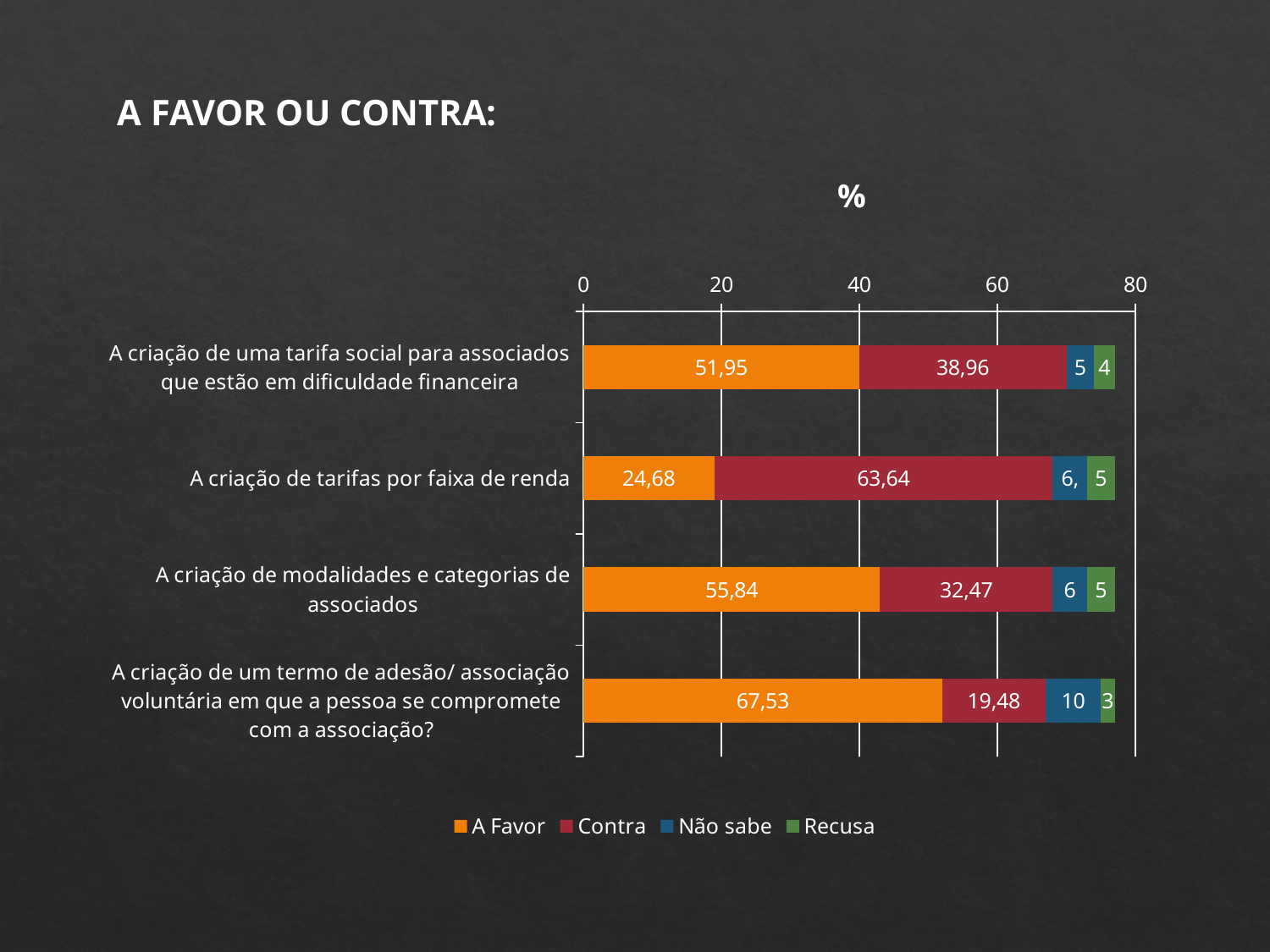
How many series does the legend list? 4 For 'A criação de modalidades e categorias de associados', which is larger: the 'A Favor' value or the 'Contra' value? A Favor What is the 'Não sabe' value for 'A criação de um termo de adesão/ associação voluntária em que a pessoa se compromete com a associação?'? 10 What kind of chart is shown on the slide? Stacked bar chart How many categories are plotted on the chart? 4 What is the 'A Favor' value for 'A criação de uma tarifa social para associados que estão em dificuldade financeira'? 51,95 Which category has the highest 'A Favor' value? A criação de um termo de adesão/ associação voluntária em que a pessoa se compromete com a associação? What is the 'Contra' value for 'A criação de tarifas por faixa de renda'? 63,64 What is the 'Recusa' value for 'A criação de modalidades e categorias de associados'? 5 What is the title of the chart? % What is the difference between the 'A Favor' and 'Contra' values for 'A criação de um termo de adesão/ associação voluntária em que a pessoa se compromete com a associação?'? 48,05 Which category has the lowest 'A Favor' value? A criação de tarifas por faixa de renda